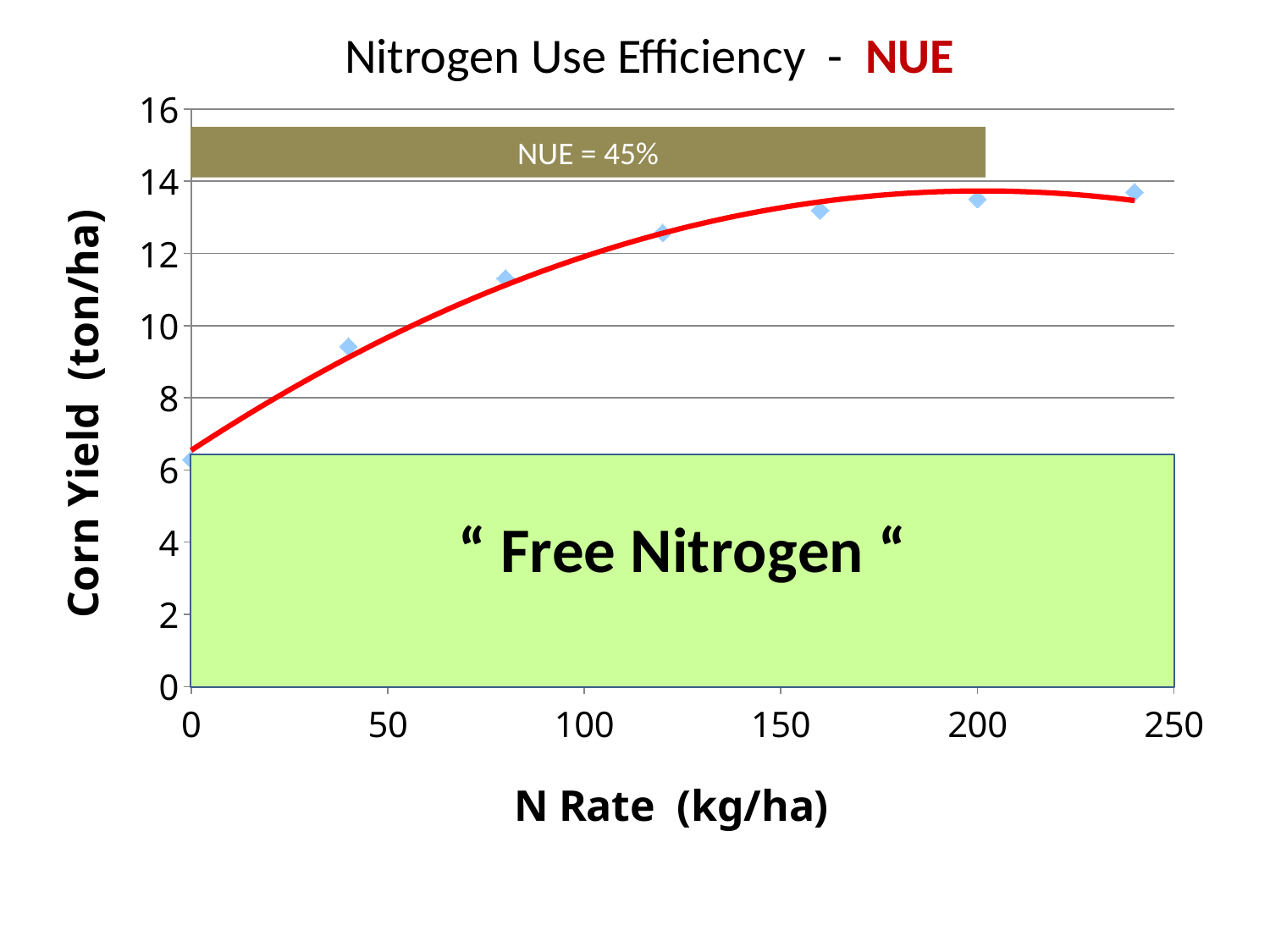
What is the label of the y axis? Corn Yield (ton/ha) Does corn yield generally rise or fall as N rate increases from 0 to 200? rise Which N rate has the lowest corn yield? 0 Is the corn yield at an N rate of 120 greater or less than 12 ton/ha? greater Is the corn yield at an N rate of 200 greater or less than 14 ton/ha? less What is the title of the chart? Nitrogen Use Efficiency - NUE Is the corn yield at an N rate of 0 greater or less than 8 ton/ha? less How many data points are plotted on the chart? 7 Which has the higher corn yield, an N rate of 40 or an N rate of 120? 120 What kind of chart is shown on the slide? scatter chart